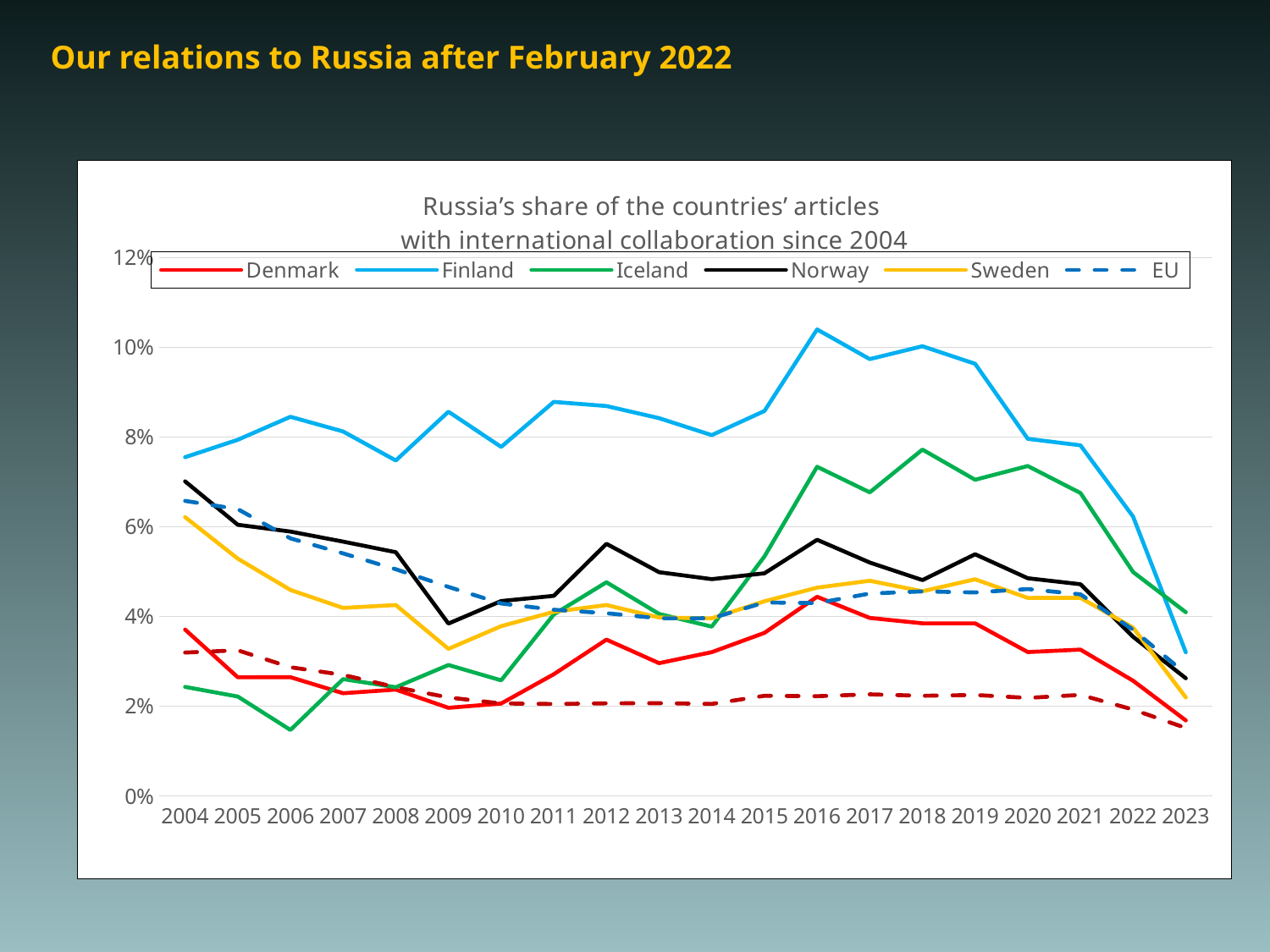
Which is larger in 2004, the value for Norway or the value for Denmark? Norway Is the value for Finland in 2016 greater or less than 10%? greater What kind of chart is shown on the slide? line chart Which series has the highest value in 2016? Finland How many series does the legend list? 6 What is the first line of the chart title? Russia’s share of the countries’ articles Which is larger in 2019, the value for Iceland or the value for Sweden? Iceland How many years are shown along the x axis? 20 Which series has the lowest value in 2006? Iceland Is the value for Iceland in 2018 greater or less than 8%? less Does the value for Finland rise or fall between 2021 and 2023? fall